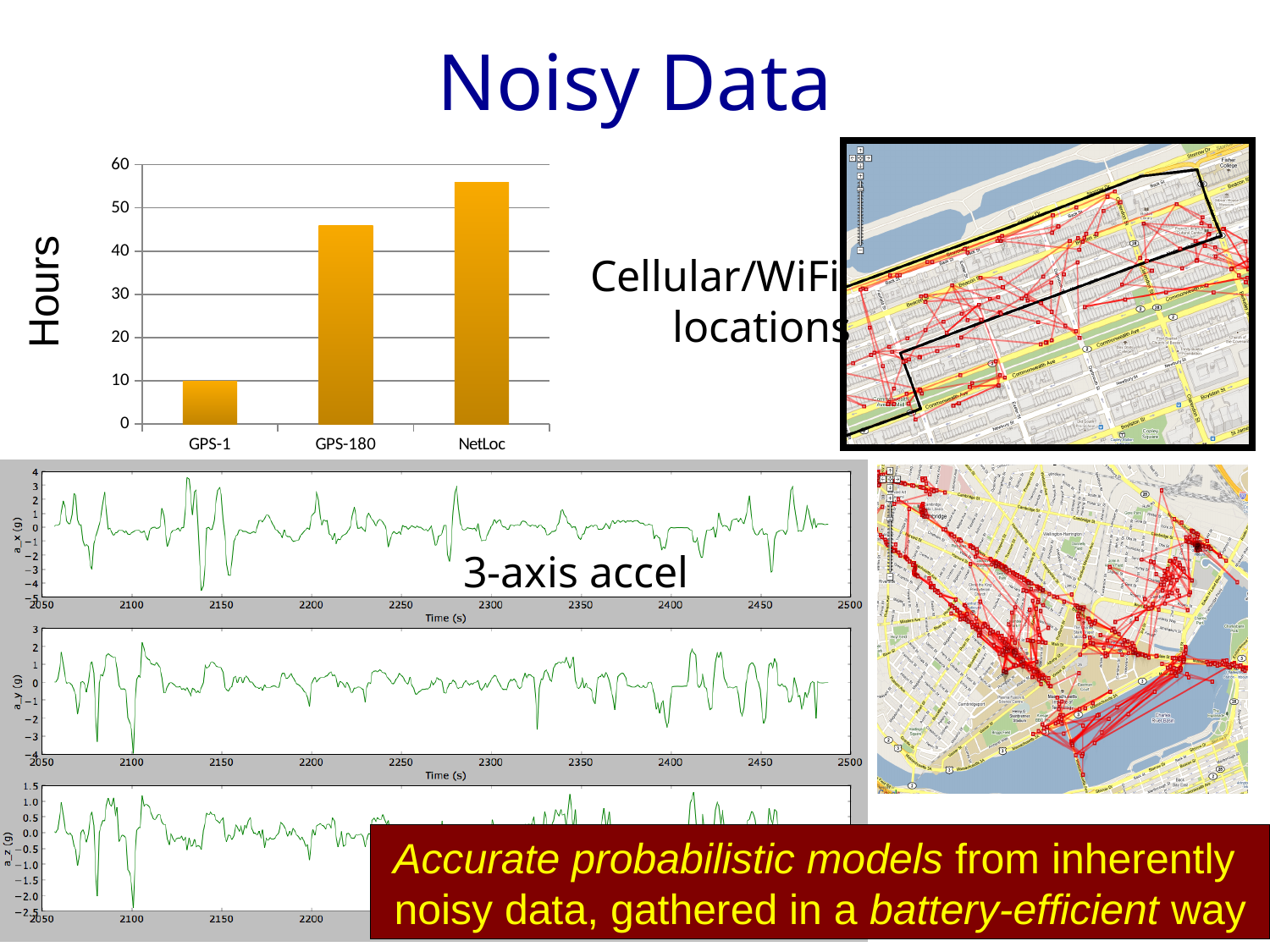
In the bar chart at the top left, is the value for GPS-1 greater or less than 20? less What is the x-axis label of the 3-axis accel line charts at the bottom left? Time (s) In the bar chart at the top left, is the value for GPS-180 greater or less than 40? greater In the bar chart at the top left, which is larger, GPS-180 or NetLoc? NetLoc In the bar chart at the top left, which category has the highest value? NetLoc In the bar chart at the top left, is the value for GPS-180 greater or less than 50? less Do the bar values in the top-left chart rise or fall from GPS-1 to NetLoc? rise What kind of chart is the one at the top left with GPS-1, GPS-180 and NetLoc? bar chart What is the y-axis label of the bar chart at the top left? Hours In the bar chart at the top left, which category has the lowest value? GPS-1 How many categories are shown in the bar chart at the top left? 3